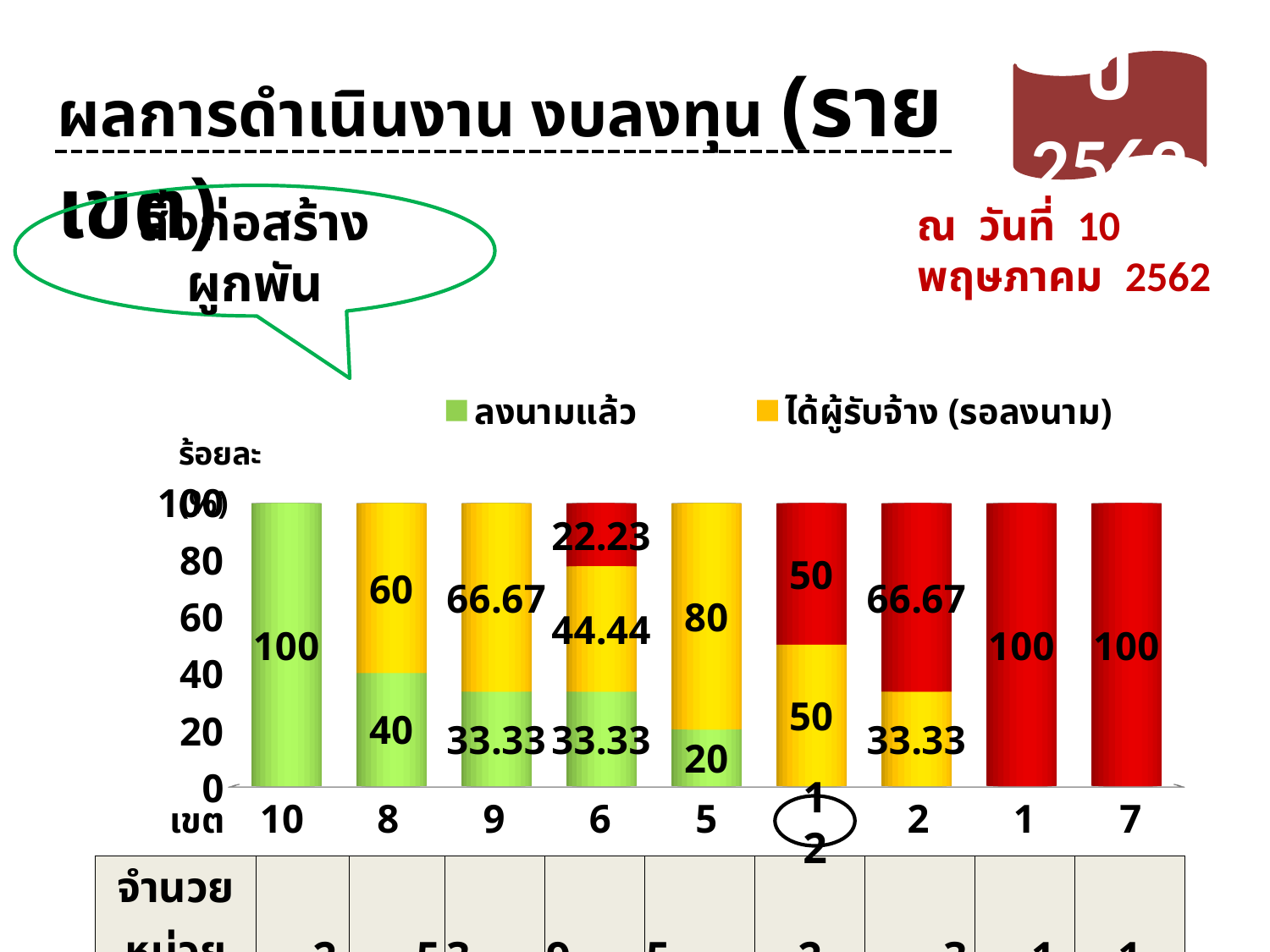
How many เขต categories are shown on the x axis of the chart? 9 What is the label of the first legend entry (green)? ลงนามแล้ว Which is larger, the ลงนามแล้ว value for เขต 8 or for เขต 5? เขต 8 How many series does the legend list? 2 What is the difference between the ได้ผู้รับจ้าง (รอลงนาม) values for เขต 5 and เขต 8? 20 What is the value of ลงนามแล้ว for เขต 9? 33.33 Which เขต has the highest ลงนามแล้ว value? เขต 10 What kind of chart is shown on the slide? stacked bar chart What is the value of ได้ผู้รับจ้าง (รอลงนาม) for เขต 6? 44.44 What is the value of ลงนามแล้ว for เขต 10? 100 What is the value of ลงนามแล้ว for เขต 8? 40 What is the value of ได้ผู้รับจ้าง (รอลงนาม) for เขต 5? 80